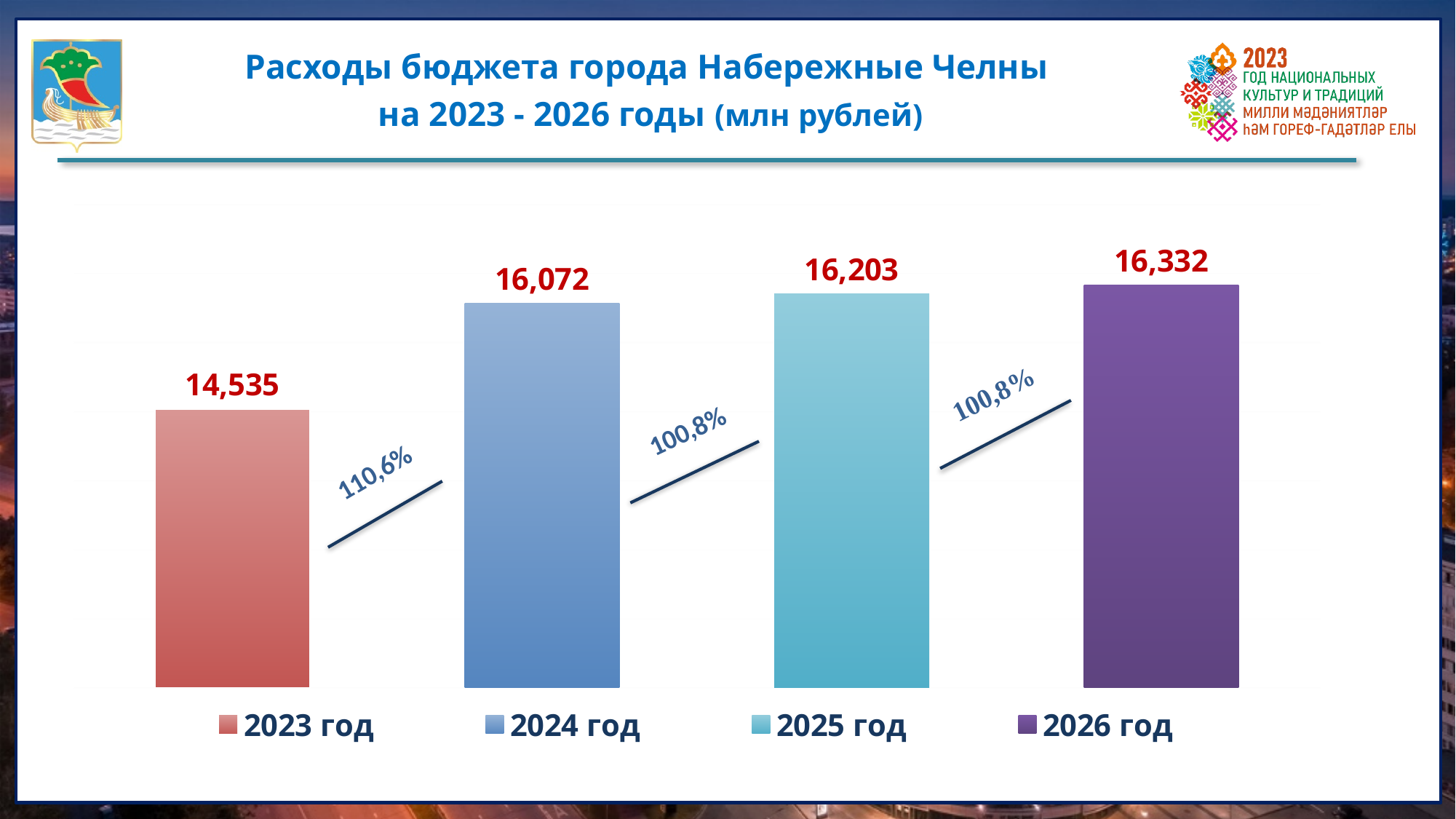
What kind of chart is shown on the slide? Bar chart What growth percentage is shown between 2023 год and 2024 год? 110,6% What is the budget expenditure value shown for 2023 год? 14,535 Which is larger, the value for 2025 год or 2024 год? 2025 год What is the value shown for 2026 год? 16,332 What is the value shown for 2025 год? 16,203 How many years (bars) are shown in the chart? 4 What is the value shown for 2024 год? 16,072 What is the difference between the values for 2024 год and 2023 год? 1,537 Do the values rise or fall from 2023 год to 2026 год? Rise Which year has the highest budget expenditure? 2026 год Which year has the lowest budget expenditure? 2023 год